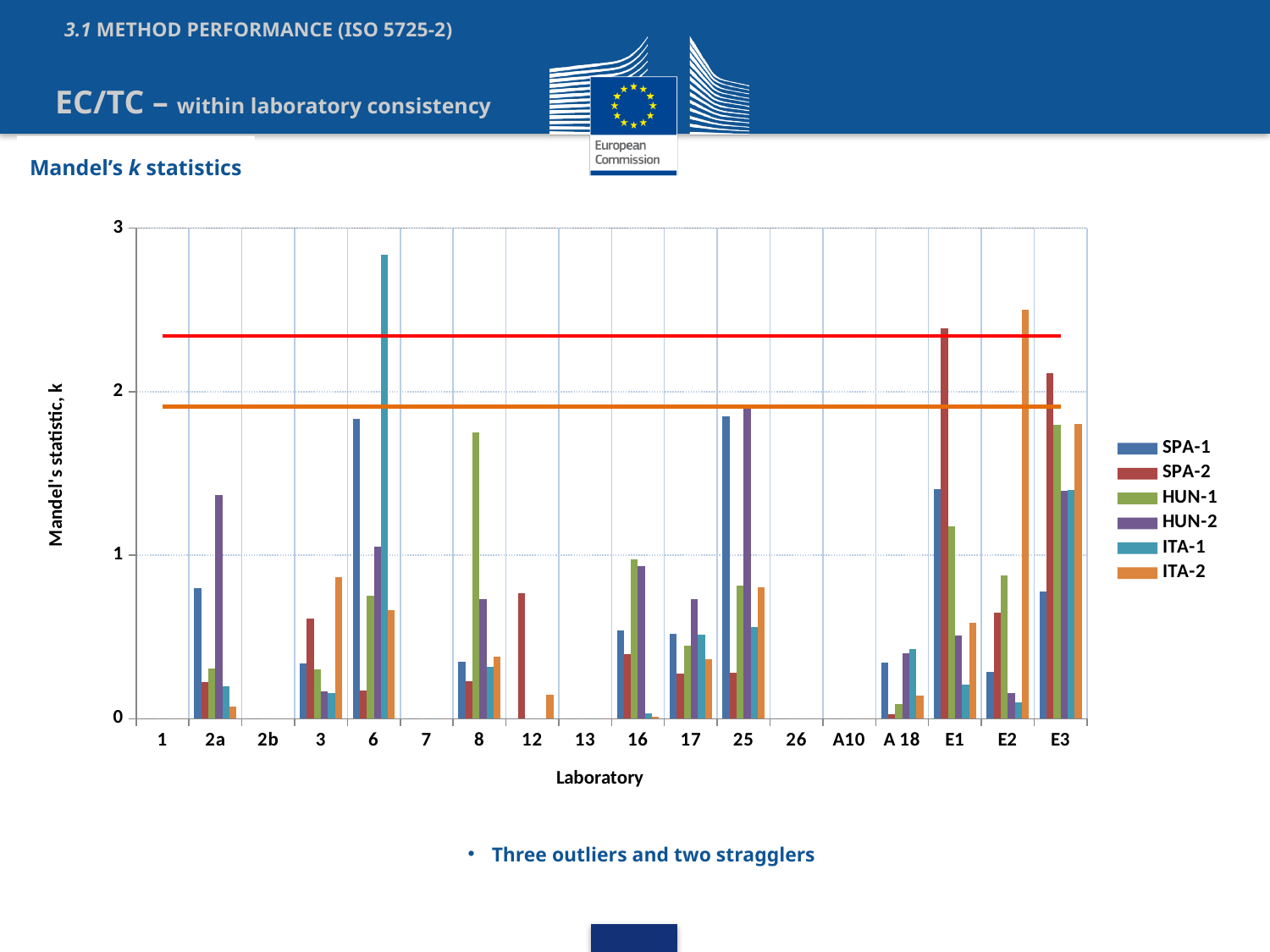
Which series has the tallest bar for laboratory E2? ITA-2 Which series has the tallest bar for laboratory 2a? HUN-2 What is the title of the y axis? Mandel's statistic, k Is the value for ITA-1 at laboratory 6 greater or less than 2? greater Is the value for SPA-1 at laboratory 6 greater or less than 2? less How many laboratory categories are shown on the x axis? 18 Which is larger at laboratory E1: the SPA-2 bar or the HUN-1 bar? SPA-2 How many series does the legend list? 6 Is the value for HUN-2 at laboratory 2a greater or less than 1? greater Which series has the tallest bar for laboratory 8? HUN-1 What kind of chart is shown on the slide? bar chart